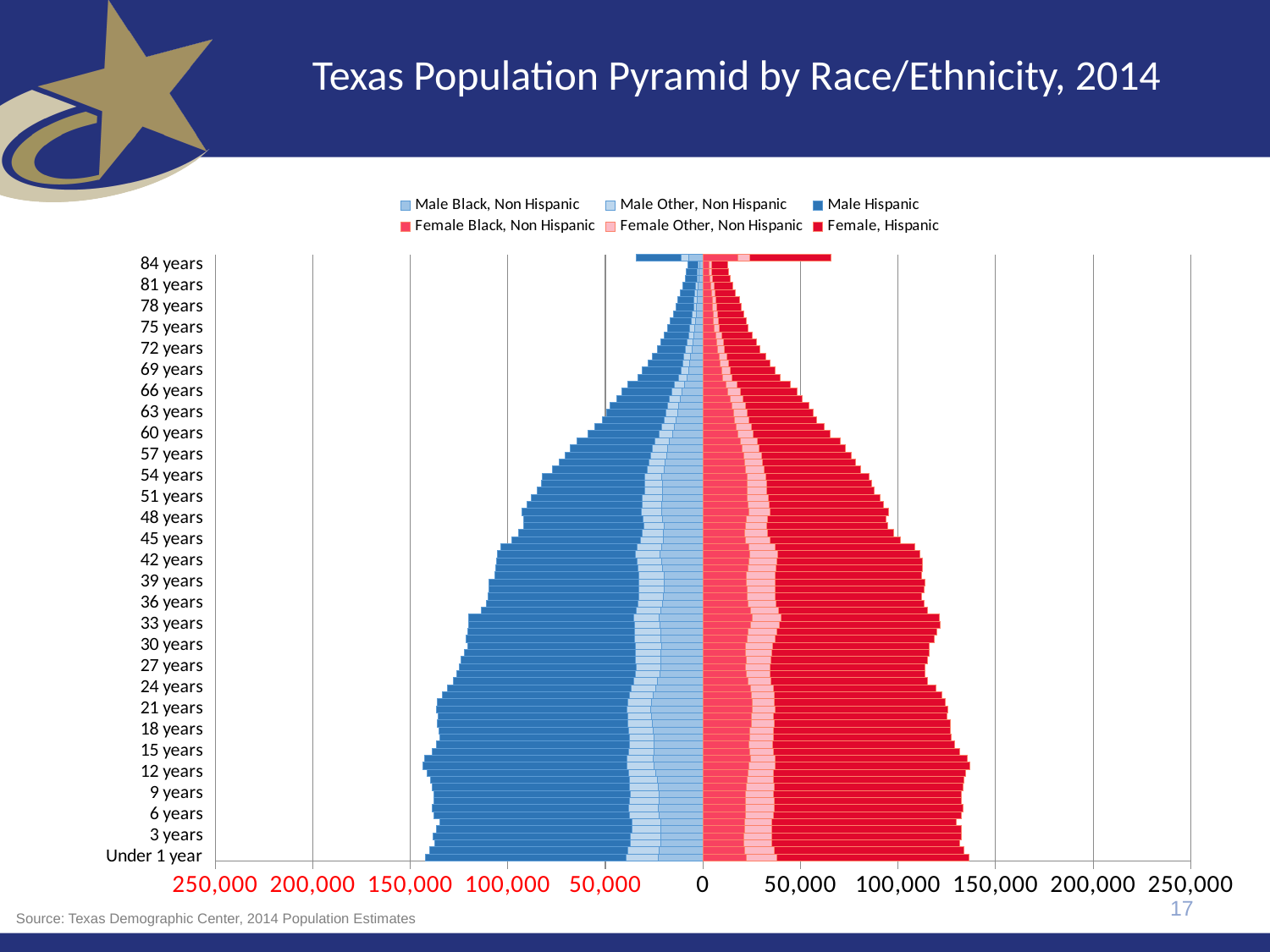
Is the total male bar for 84 years greater or less than 50,000? less What is the title of the chart? Texas Population Pyramid by Race/Ethnicity, 2014 Do the bar lengths generally increase or decrease as age increases from Under 1 year to 84 years? decrease Is the total female bar for Under 1 year greater or less than 100,000? greater What is the largest value shown on the horizontal axis? 250,000 Is the total male bar for 12 years greater or less than 100,000? greater What kind of chart is shown on the slide? Bar chart (population pyramid) How many series does the legend list? 6 Which is larger, the total male bar for Under 1 year or the total male bar for 84 years? Under 1 year